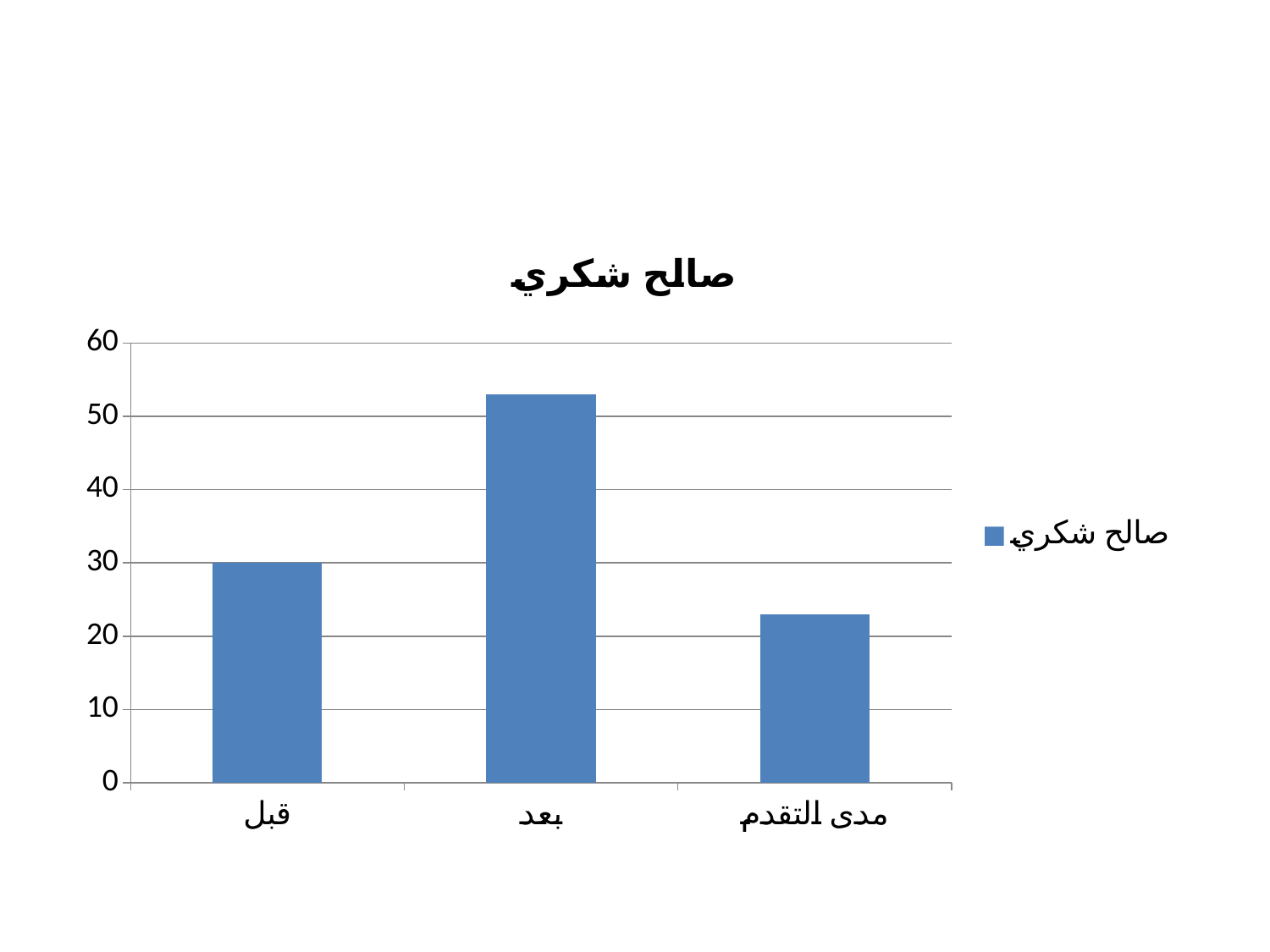
What is the title of the chart? صالح شكري How many categories are shown on the x axis of the chart? 3 Is the value for بعد greater or less than 50? greater Which category has the lowest value? مدى التقدم Which category has the highest value? بعد Which is larger, the value for قبل or the value for بعد? بعد How many series does the legend list? 1 Which is larger, the value for قبل or the value for مدى التقدم? قبل What is the value for قبل? 30 Is the value for مدى التقدم greater or less than 30? less What type of chart is shown on the slide? bar chart What is the name of the series shown in the legend? صالح شكري